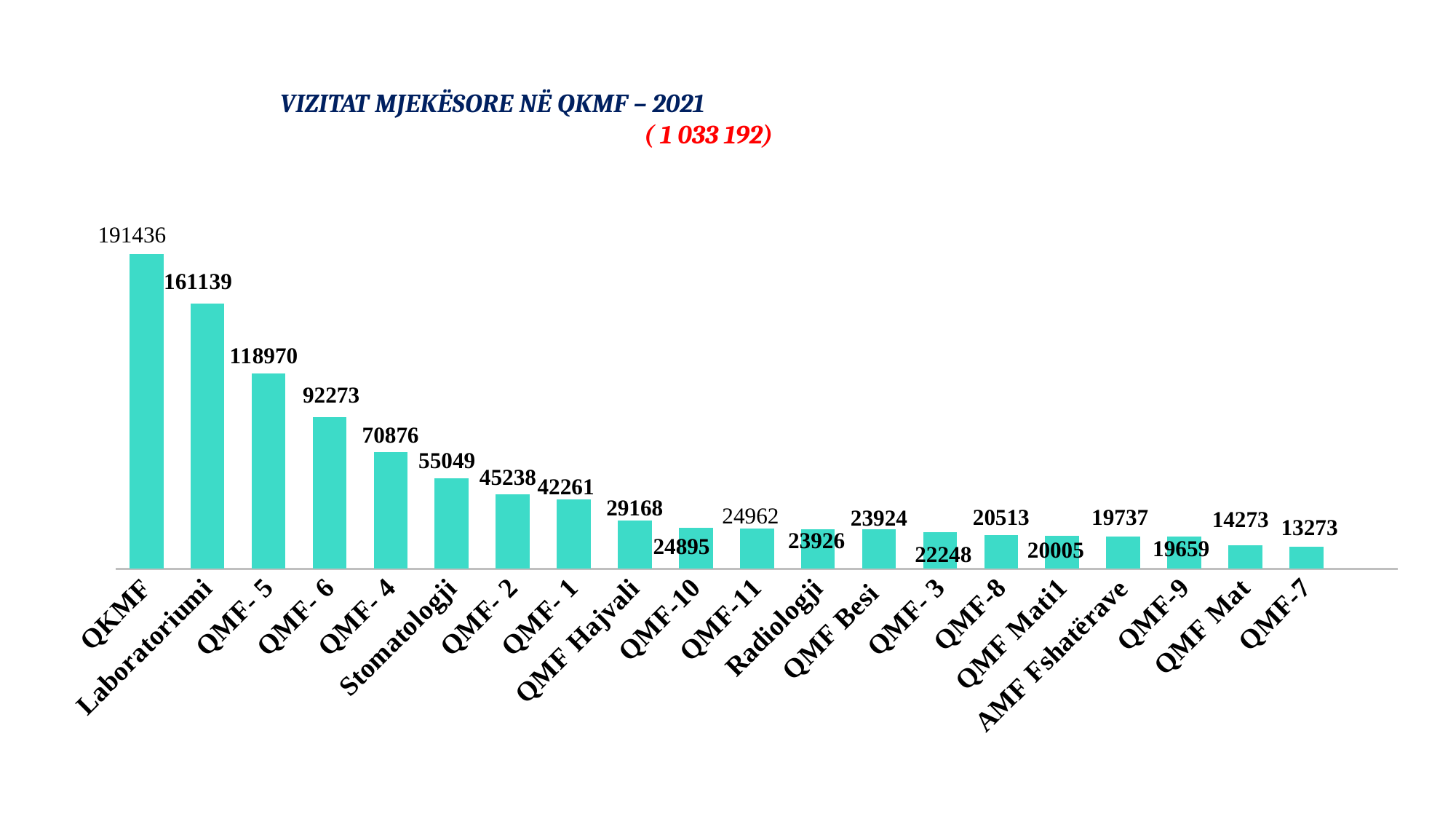
Which category has the lowest value? QMF-7 What is the value for Stomatologji? 55049 What kind of chart is shown on the slide? Bar chart What is the value for AMF Fshatërave? 19737 Which is larger, the value for QMF- 5 or the value for QMF- 6? QMF- 5 Which category has the highest value? QKMF How many categories are shown in the chart? 20 What is the value for Laboratoriumi? 161139 What is the difference between the values for QKMF and Laboratoriumi? 30297 What total is shown in red below the chart title? ( 1 033 192) What is the value for QKMF? 191436 What is the value for QMF Hajvali? 29168